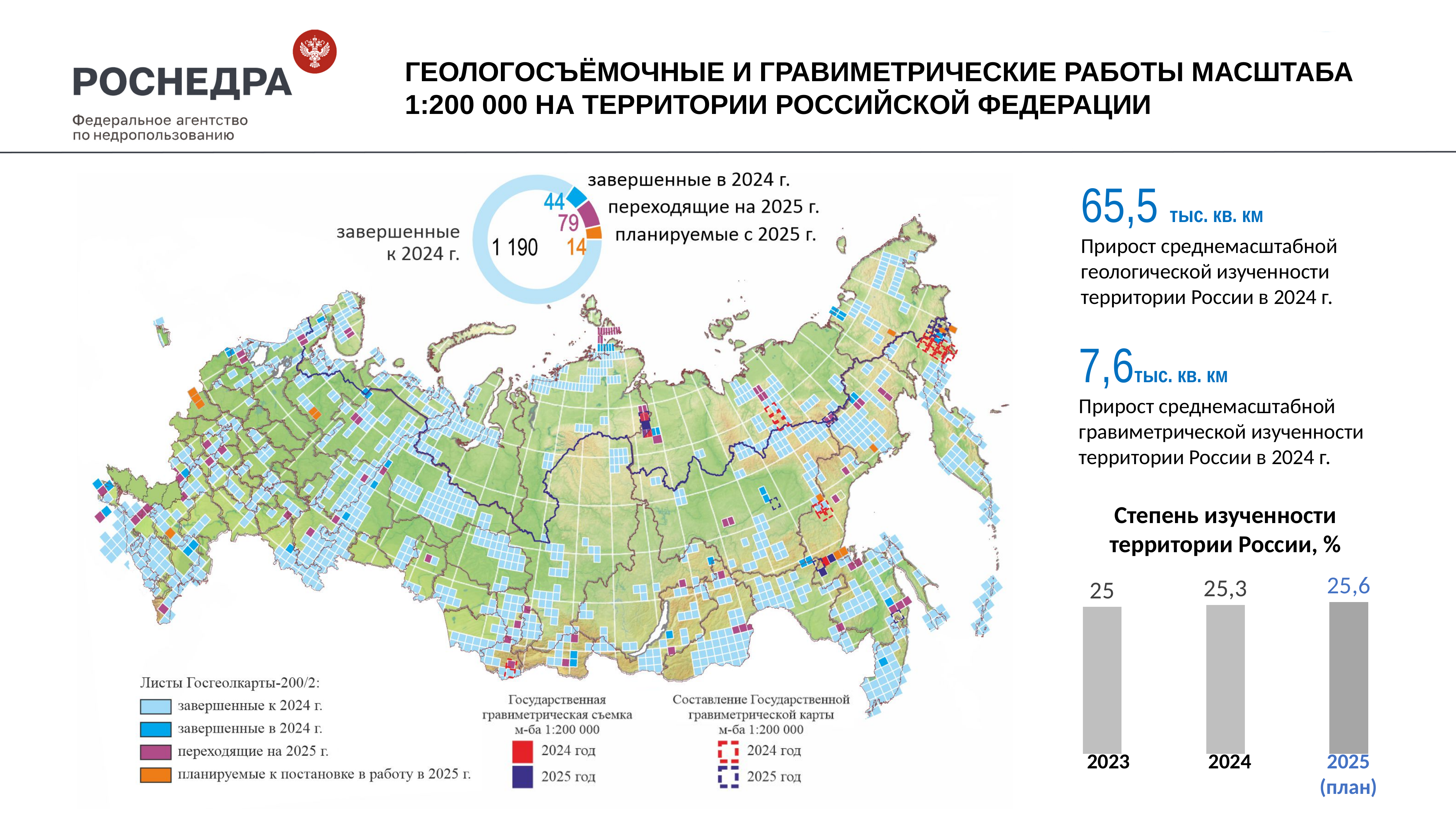
In the donut chart above the map, what is the value for 'переходящие на 2025 г.'? 79 In the donut chart above the map, which is larger: 'завершенные в 2024 г.' or 'планируемые с 2025 г.'? завершенные в 2024 г. In the bar chart 'Степень изученности территории России, %', what is the value for 2023? 25 What kind of chart is 'Степень изученности территории России, %'? bar chart In the bar chart 'Степень изученности территории России, %', what is the difference between the 2025 (план) value and the 2023 value? 0,6 In the bar chart 'Степень изученности территории России, %', what is the planned value for 2025? 25,6 In the bar chart 'Степень изученности территории России, %', do the values rise or fall from 2023 to 2025? rise In the bar chart 'Степень изученности территории России, %', which year has the highest value? 2025 (план) In the bar chart 'Степень изученности территории России, %', which year has the lowest value? 2023 How many bars are shown in the bar chart 'Степень изученности территории России, %'? 3 In the donut chart above the map, what is the value for 'завершенные к 2024 г.'? 1 190 In the bar chart 'Степень изученности территории России, %', what is the value for 2024? 25,3